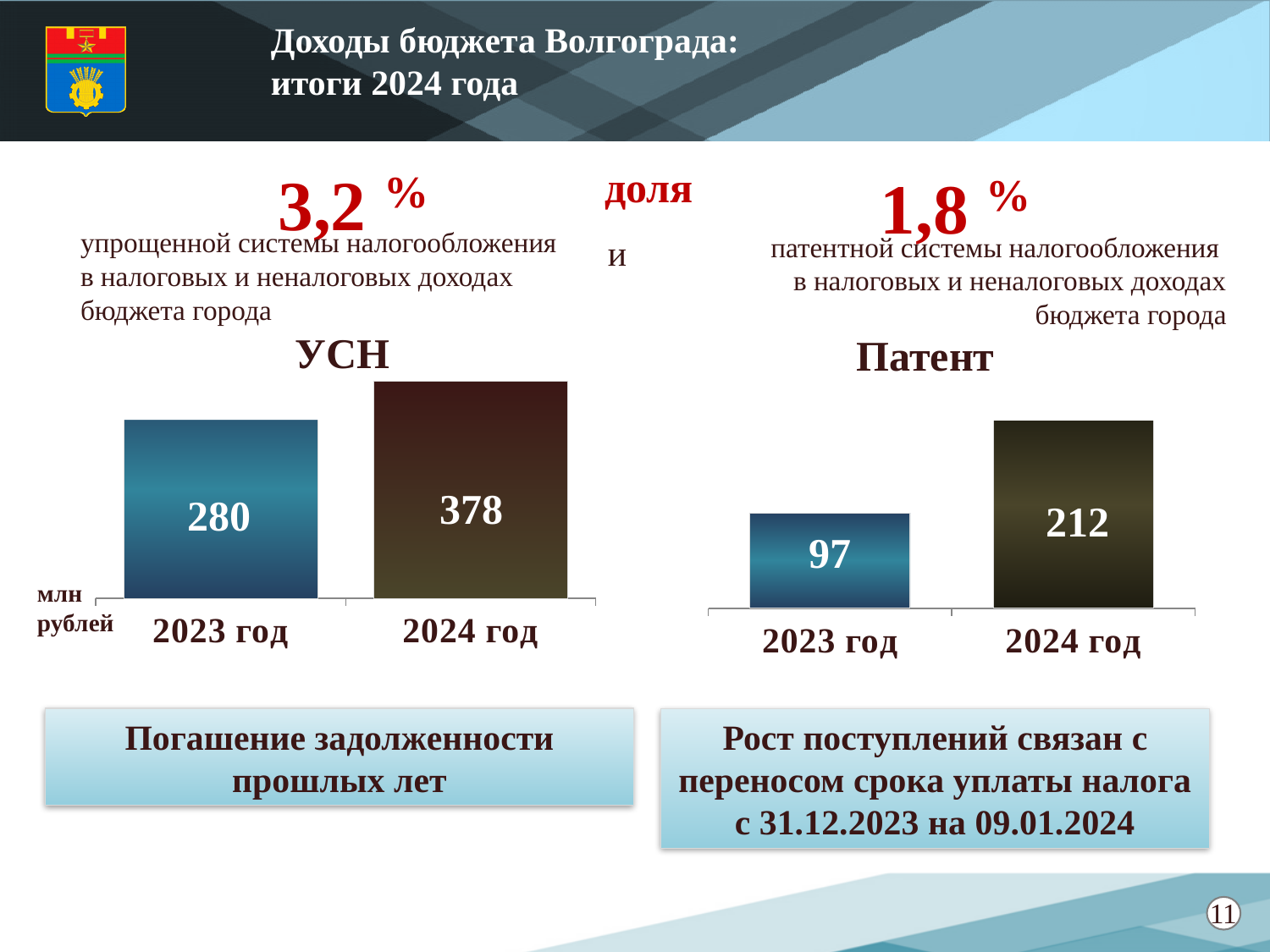
In the УСН chart, what is the difference between the 2024 год and 2023 год values? 98 How many bars does the УСН chart have? 2 In the Патент chart, what is the value for 2023 год? 97 Is the 2024 год value in the Патент chart larger or smaller than the 2023 год value in the УСН chart? smaller What type of chart is the Патент chart? bar chart In the УСН chart, which year has the higher value? 2024 год In the Патент chart, what is the value for 2024 год? 212 In the УСН chart, what is the value for 2023 год? 280 In the Патент chart, which year has the lower value? 2023 год In the Патент chart, what is the difference between the 2024 год and 2023 год values? 115 In the УСН chart, what is the value for 2024 год? 378 In the УСН chart, do the values rise or fall from 2023 год to 2024 год? rise